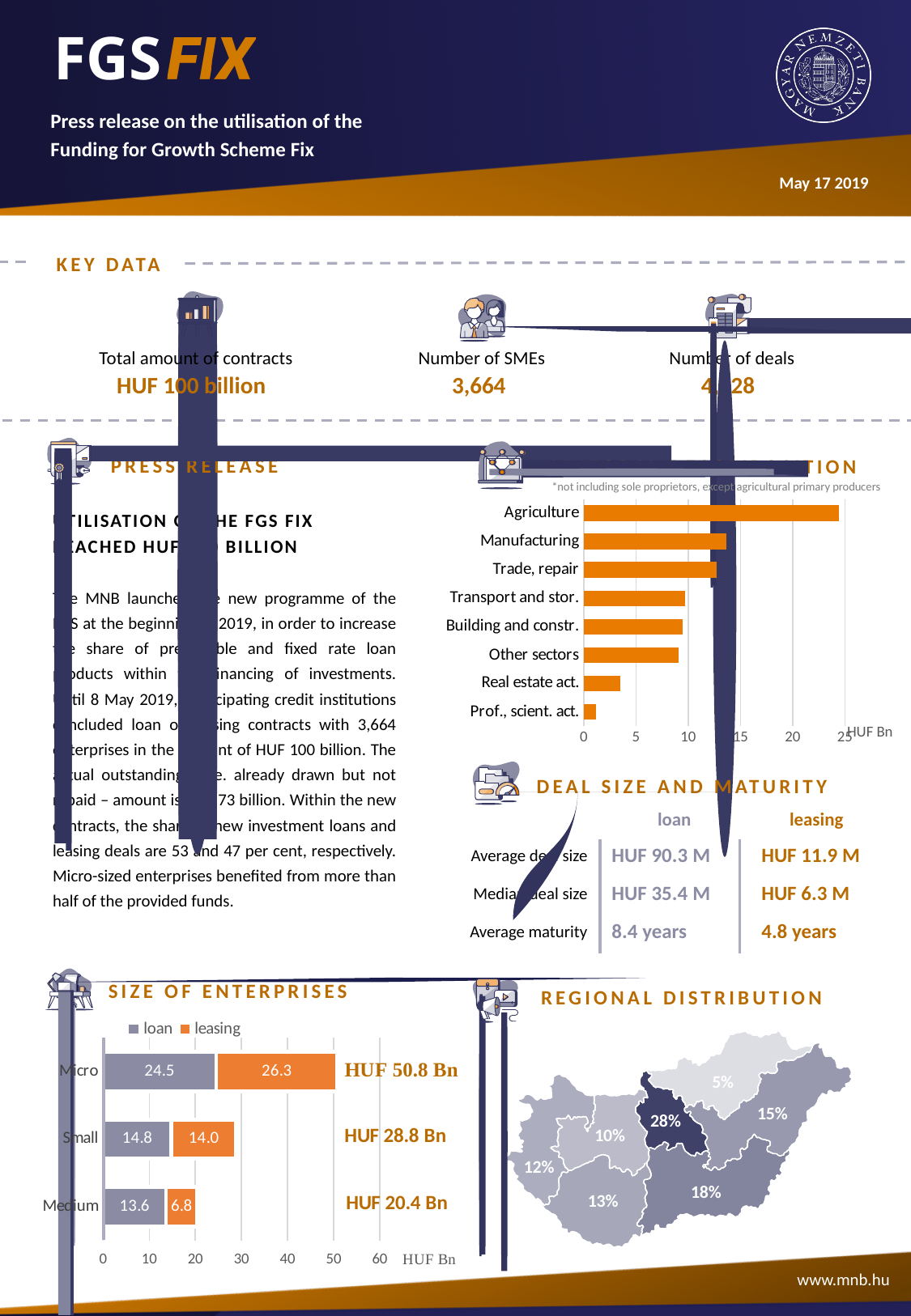
In the 'Size of enterprises' chart, what is the total shown for Small enterprises? HUF 28.8 Bn In the sector bar chart on the right (above 'Deal size and maturity'), which sector has the shortest bar? Prof., scient. act. In the 'Size of enterprises' chart, what is the loan value for Micro enterprises? 24.5 In the 'Size of enterprises' chart, what is the leasing value for Medium enterprises? 6.8 In the 'Size of enterprises' chart, what is the difference between the loan and leasing values for Medium enterprises? 6.8 How many series does the legend of the 'Size of enterprises' chart list? 2 In the 'Size of enterprises' chart, which enterprise size has the highest total? Micro How many sectors are shown in the sector bar chart on the right (above 'Deal size and maturity')? 8 In the 'Size of enterprises' chart, which is larger for Micro enterprises, loan or leasing? leasing In the sector bar chart on the right (above 'Deal size and maturity'), which sector has the longest bar? Agriculture What kind of chart is the 'Size of enterprises' chart? stacked bar chart In the sector bar chart on the right (above 'Deal size and maturity'), is the value for Agriculture greater or less than 20? greater